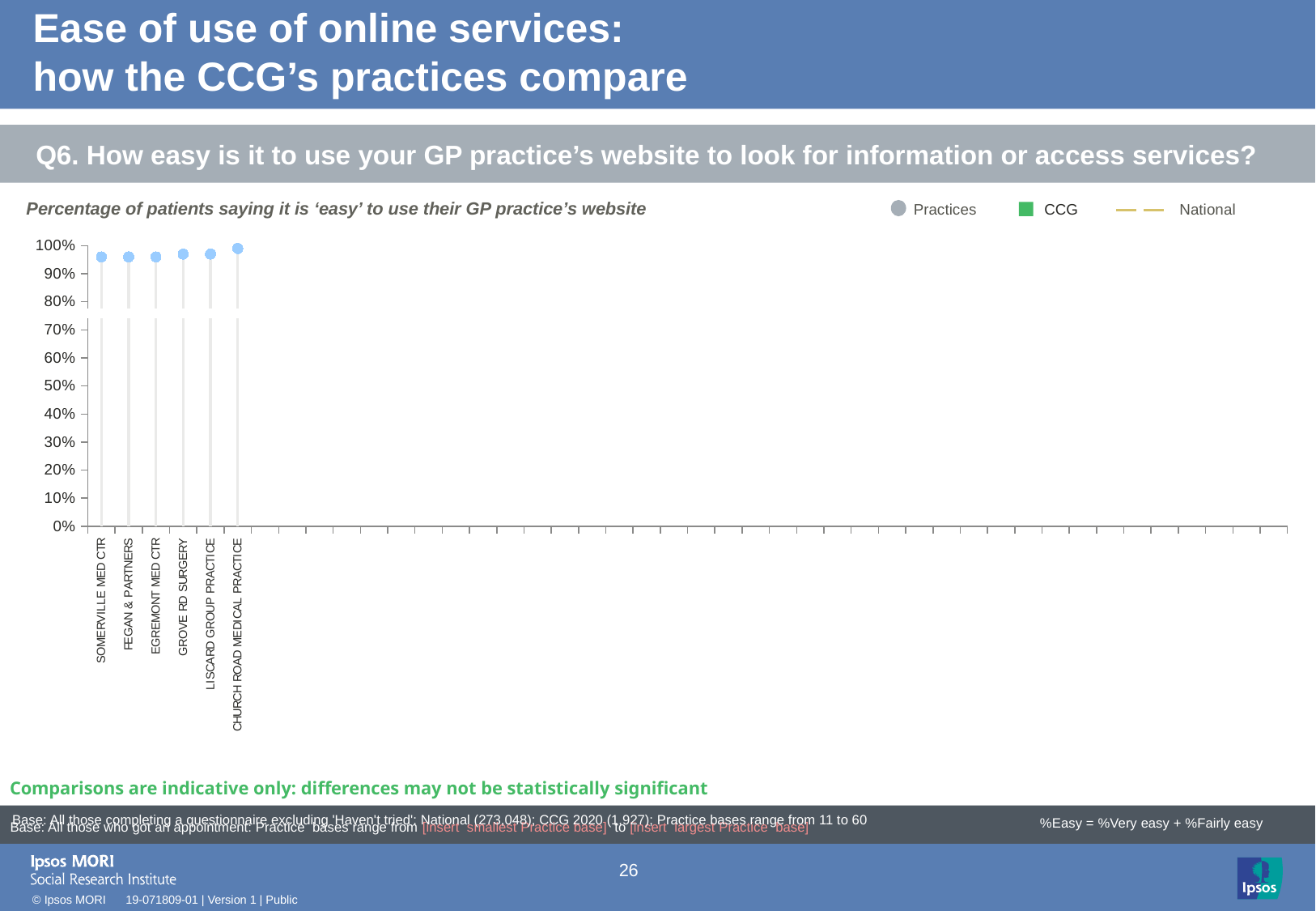
How many practices are plotted on the chart? 6 Is the value for FEGAN & PARTNERS greater or less than 80%? greater Is the value for CHURCH ROAD MEDICAL PRACTICE greater or less than 90%? greater Do the plotted values generally rise or fall moving from left to right along the x axis? rise What are the three entries in the chart legend? Practices, CCG, National Is the value for SOMERVILLE MED CTR greater or less than 90%? greater What is the highest value shown on the y axis? 100% Which practice has the highest percentage of patients saying it is 'easy' to use their GP practice's website? CHURCH ROAD MEDICAL PRACTICE What is the first practice listed on the x axis? SOMERVILLE MED CTR Which has the larger value, CHURCH ROAD MEDICAL PRACTICE or SOMERVILLE MED CTR? CHURCH ROAD MEDICAL PRACTICE How many series does the chart legend list? 3